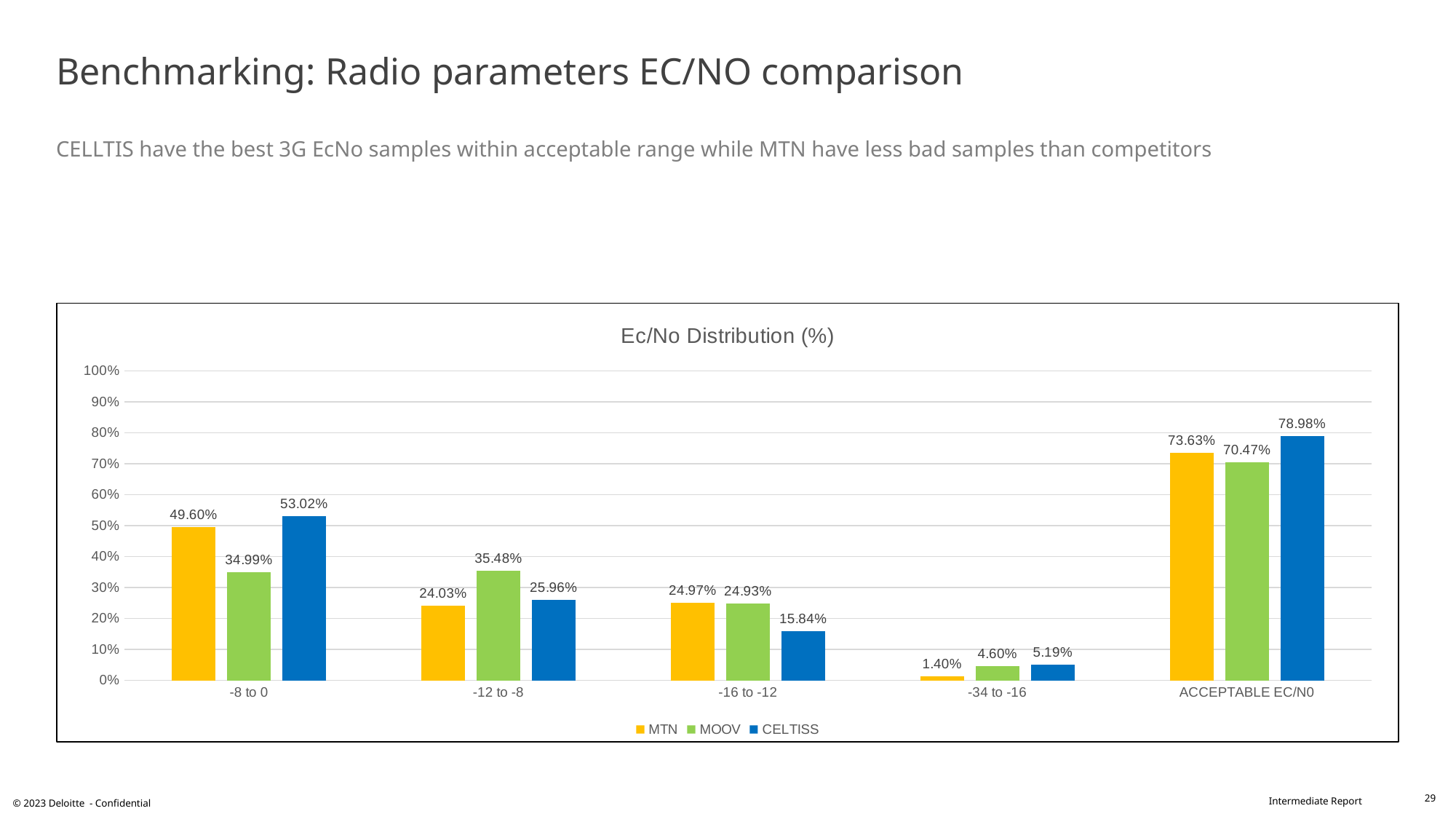
What is the title of the chart? Ec/No Distribution (%) Which is larger in the -8 to 0 category, the MTN value or the MOOV value? MTN What kind of chart is shown on the slide? Bar chart What is the MTN value for the -8 to 0 category? 49.60% How many series does the legend list? 3 What is the MOOV value for the -12 to -8 category? 35.48% Which series has the lowest value in the -16 to -12 category? CELTISS Is the MOOV value for ACCEPTABLE EC/N0 greater or less than 60%? greater Which series has the highest value in the -34 to -16 category? CELTISS How many categories are shown on the x axis? 5 What is the CELTISS value for ACCEPTABLE EC/N0? 78.98% What is the difference between the CELTISS and MTN values for ACCEPTABLE EC/N0? 5.35%